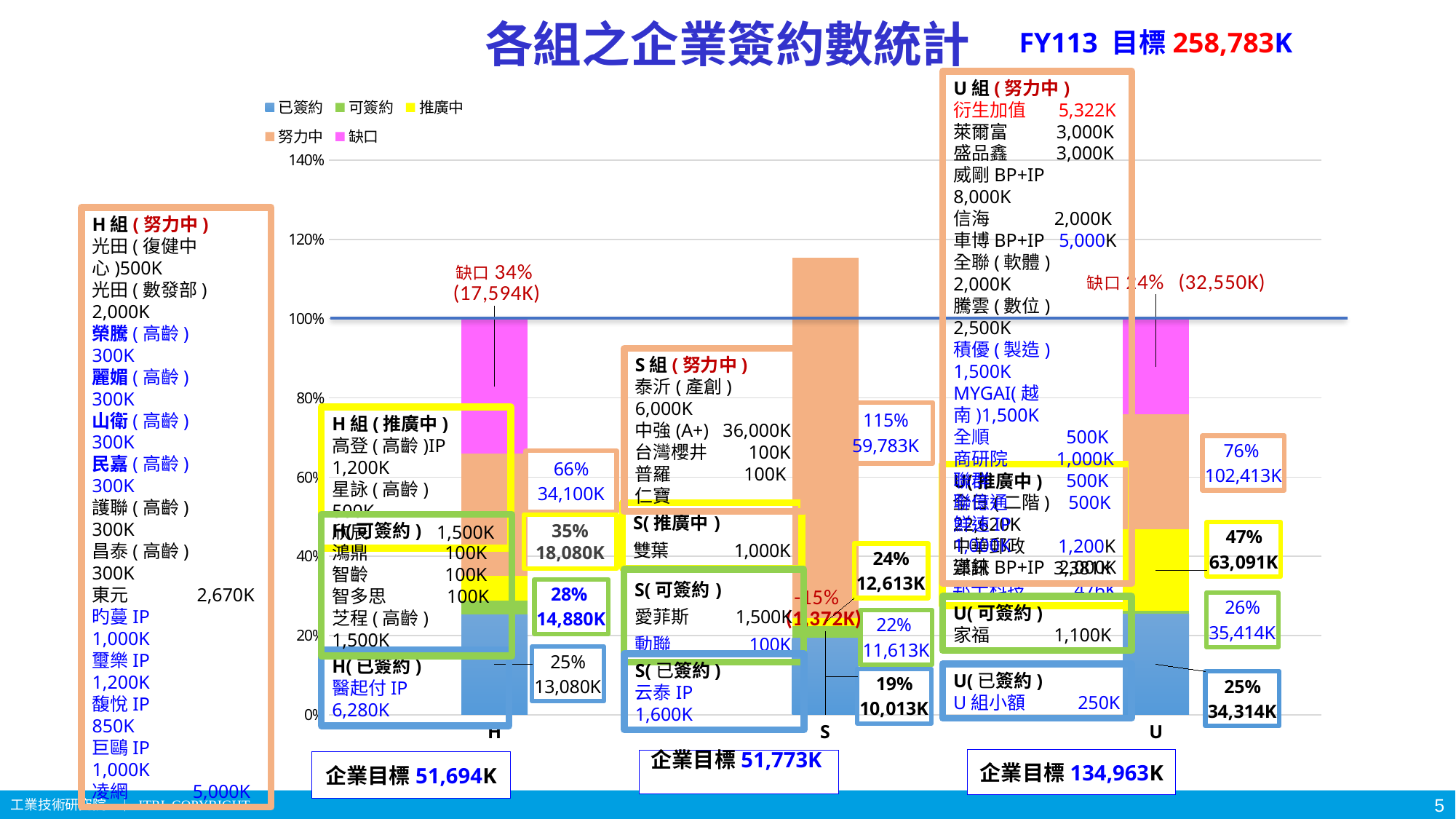
How many groups (categories) are shown on the x axis of the chart? 3 What type of chart is shown on the slide? stacked bar chart What is the 缺口 amount labelled for group U? (32,550K) What percentage is labelled for 已簽約 in group S? 19% What value is labelled for 已簽約 in group U? 34,314K What is the 缺口 percentage labelled for group H? 34% Which group has the lowest 已簽約 percentage? S How many series does the chart legend list? 5 Which group has the highest 已簽約 amount in K? U What is the 已簽約 value labelled for group H? 13,080K What is the FY113 目標 shown at the top of the slide? 258,783K What is the 企業目標 shown for group U? 134,963K